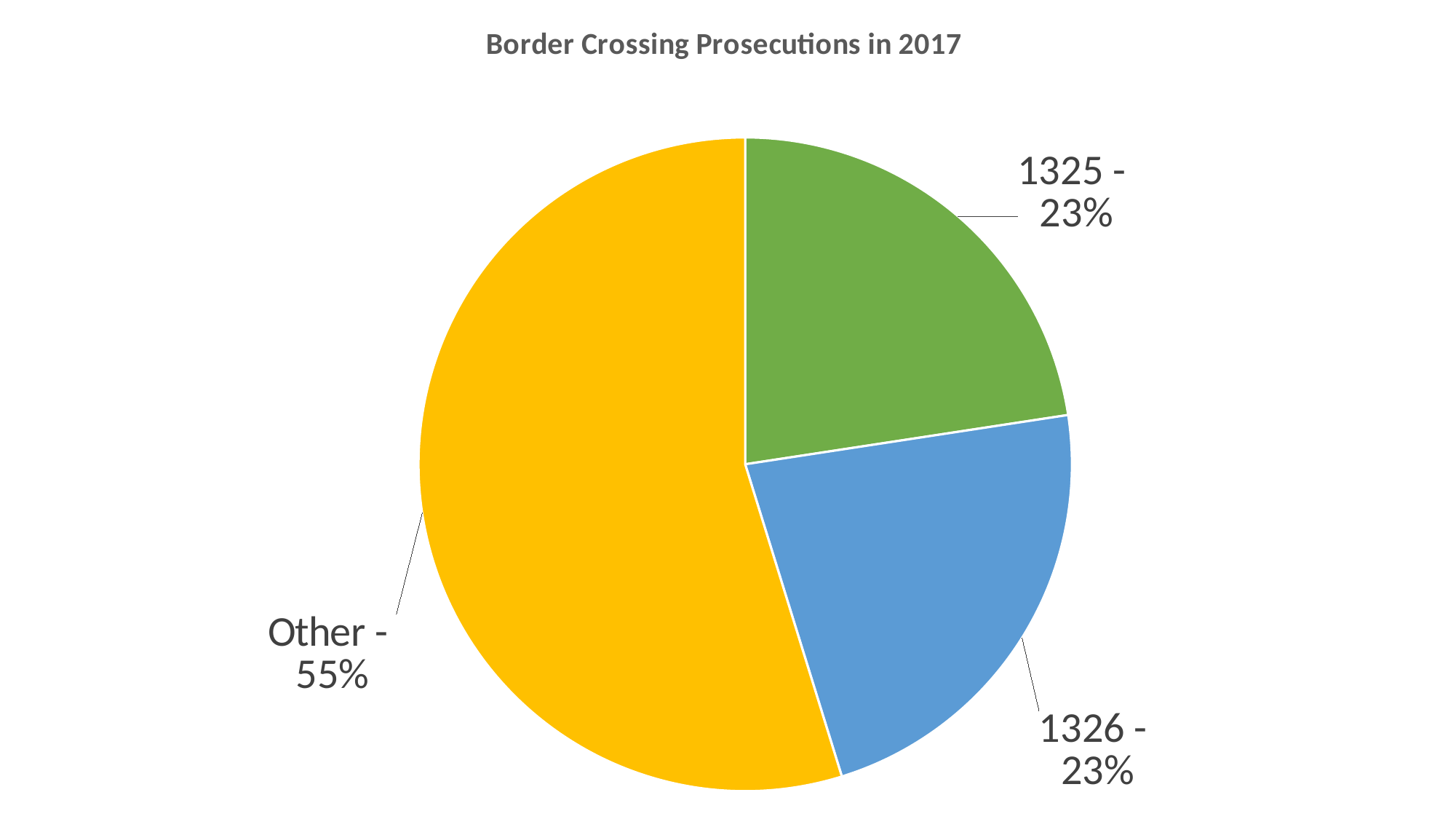
Which is larger, the share for Other or the share for 1326? Other What share of the pie does the 1325 slice represent? 23% What share of the pie does the Other slice represent? 55% What kind of chart is shown on the slide? pie chart What is the title of the chart? Border Crossing Prosecutions in 2017 What share of the pie does the 1326 slice represent? 23% Is the share for Other greater or less than 50%? greater What is the combined share of the 1325 and 1326 slices? 46% How many slices does the pie chart have? 3 What is the difference in percentage points between the Other slice and the 1325 slice? 32 What colour is the Other slice? yellow Which category has the largest share of the pie? Other